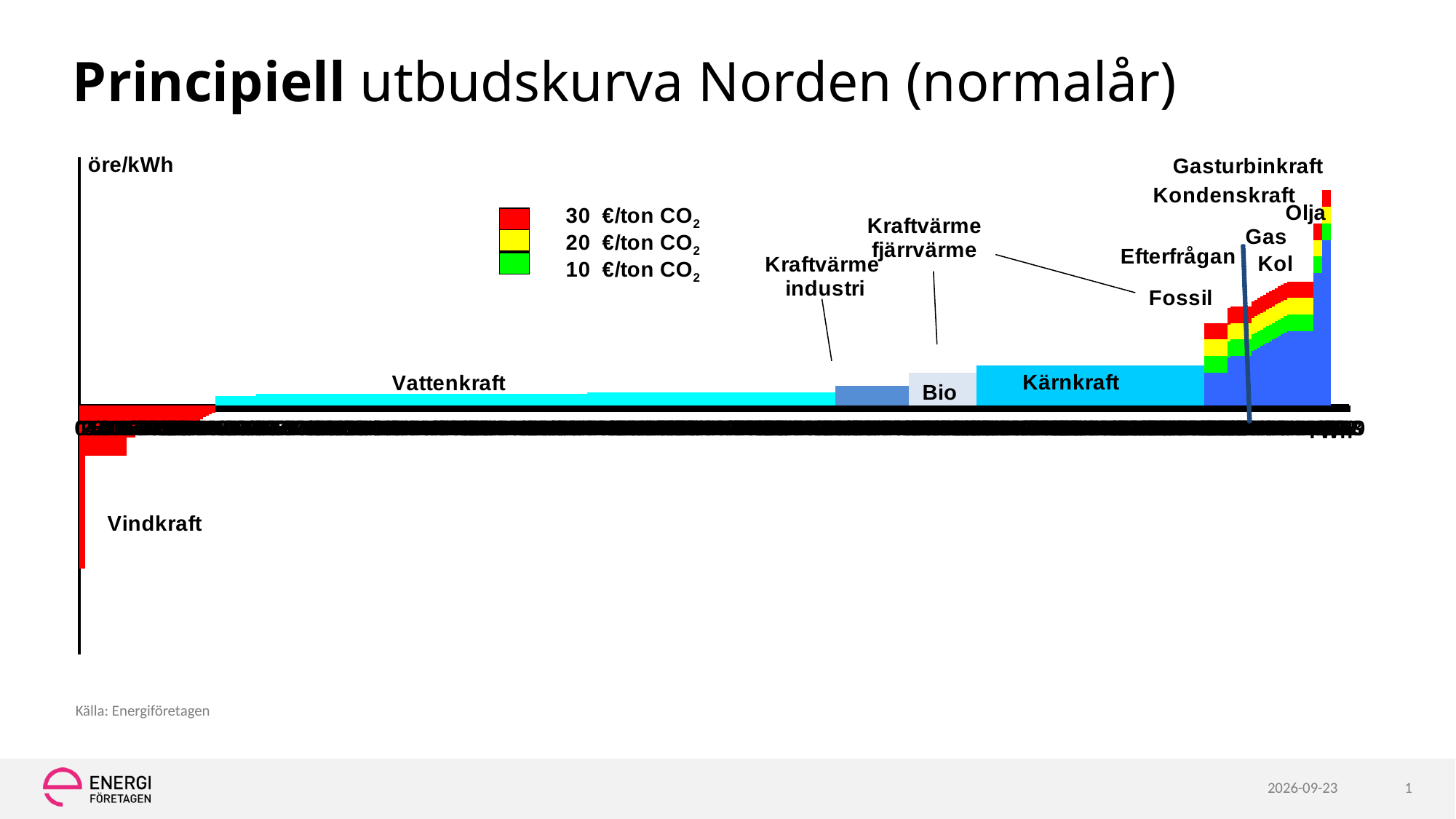
Which colour in the legend represents 30 €/ton CO2? Red Which technology is plotted below the horizontal axis, with a negative value? Vindkraft What unit is shown on the vertical axis of the chart? öre/kWh Is Kol plotted higher or lower on the curve than Olja? Lower Which technology is at the highest point of the supply curve? Gasturbinkraft Do the values of the supply curve rise or fall from left to right? Rise Which is plotted higher on the curve, Fossil or Bio? Fossil How many CO2 price levels does the legend list? 3 Is Bio plotted higher or lower on the curve than Kärnkraft? Lower